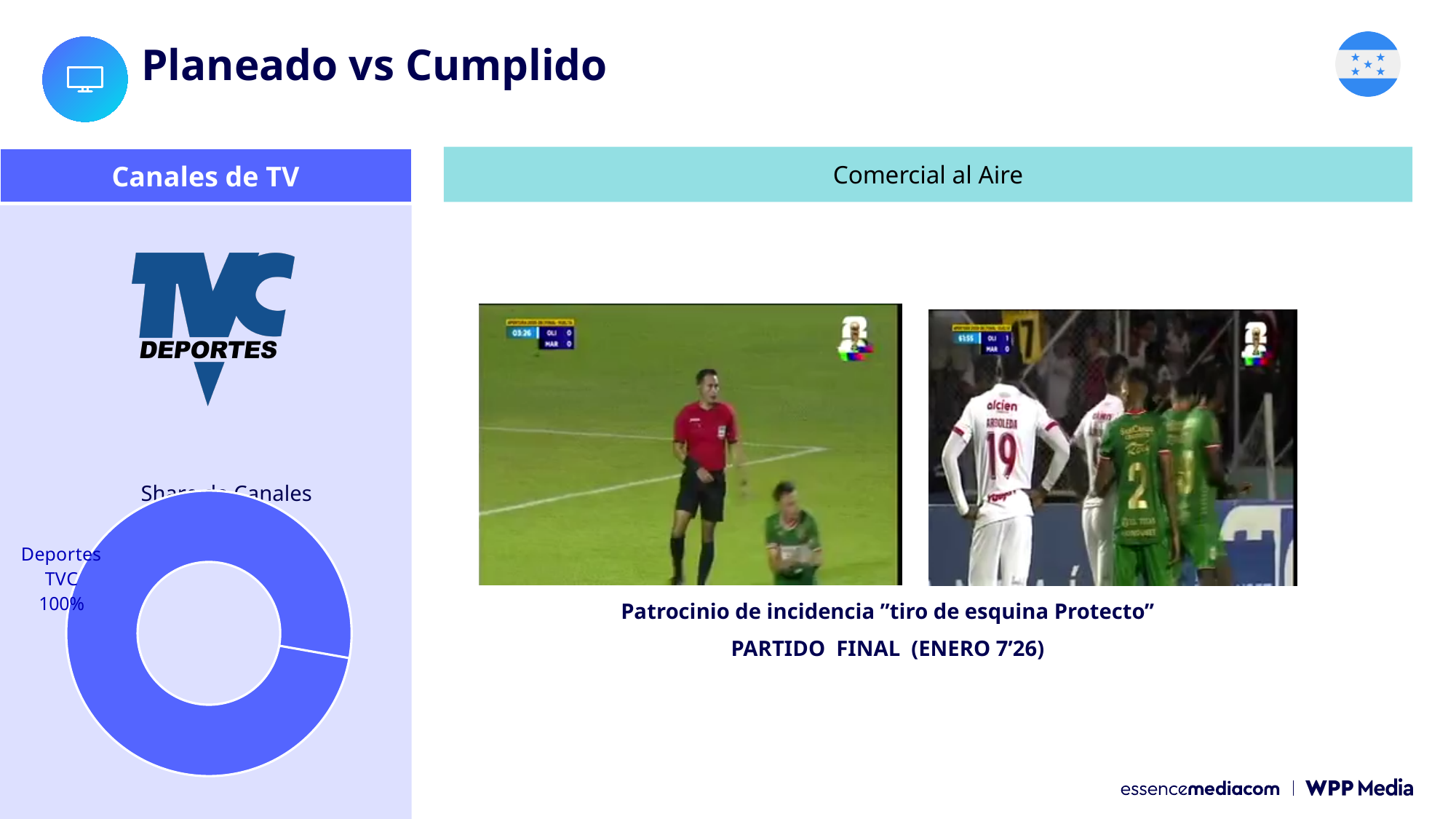
What colour is the Deportes TVC slice in the Share de Canales chart? blue In the Share de Canales chart, which channel holds the 100% share? Deportes TVC What is the title of the chart on the left of the slide? Share de Canales In the Share de Canales chart, what share is shown for Deportes TVC? 100% What kind of chart is shown under the TVC Deportes logo on the left of the slide? pie chart (donut) How many categories are labelled in the Share de Canales chart? 1